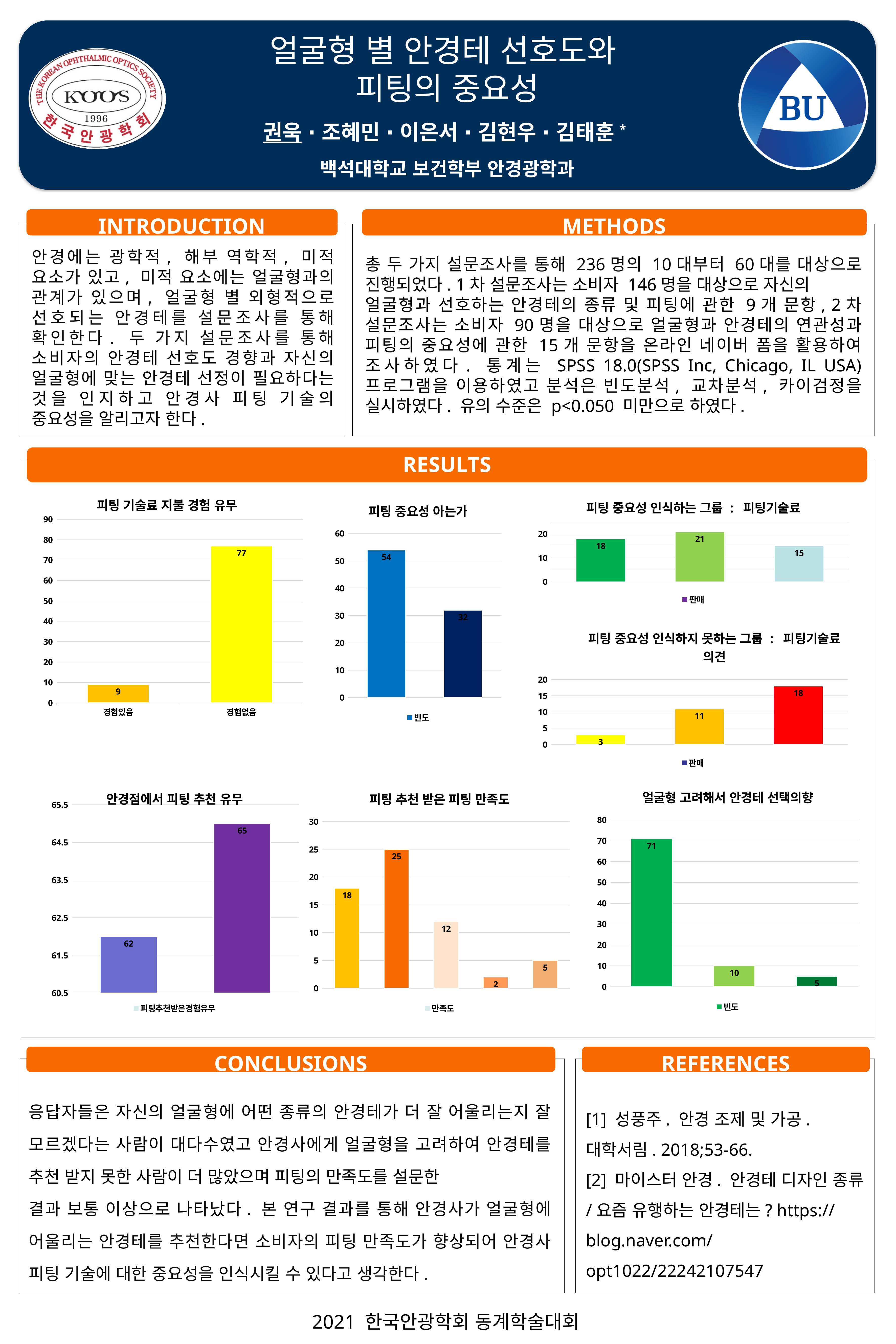
In the chart titled '피팅 추천 받은 피팅 만족도', what is the value of the lowest bar? 2 What type of chart is '얼굴형 고려해서 안경테 선택의향'? bar chart In the chart titled '피팅 기술료 지불 경험 유무', what is the difference between the values for 경험없음 and 경험있음? 68 In the chart titled '피팅 기술료 지불 경험 유무', what is the value for 경험있음? 9 How many bars are plotted in the chart titled '피팅 중요성 인식하지 못하는 그룹 : 피팅기술료 의견'? 3 In the chart titled '안경점에서 피팅 추천 유무', what is the value of the taller bar? 65 In the chart titled '피팅 중요성 인식하는 그룹 : 피팅기술료', what is the value of the lowest bar? 15 In the chart titled '피팅 중요성 인식하지 못하는 그룹 : 피팅기술료 의견', what is the value of the red bar? 18 In the chart titled '피팅 중요성 아는가', what is the total of the two bars? 86 How many bars are plotted in the chart titled '피팅 추천 받은 피팅 만족도'? 5 In the chart titled '피팅 기술료 지불 경험 유무', what is the value for 경험없음? 77 In the chart titled '피팅 중요성 아는가', what is the value of the tallest bar? 54